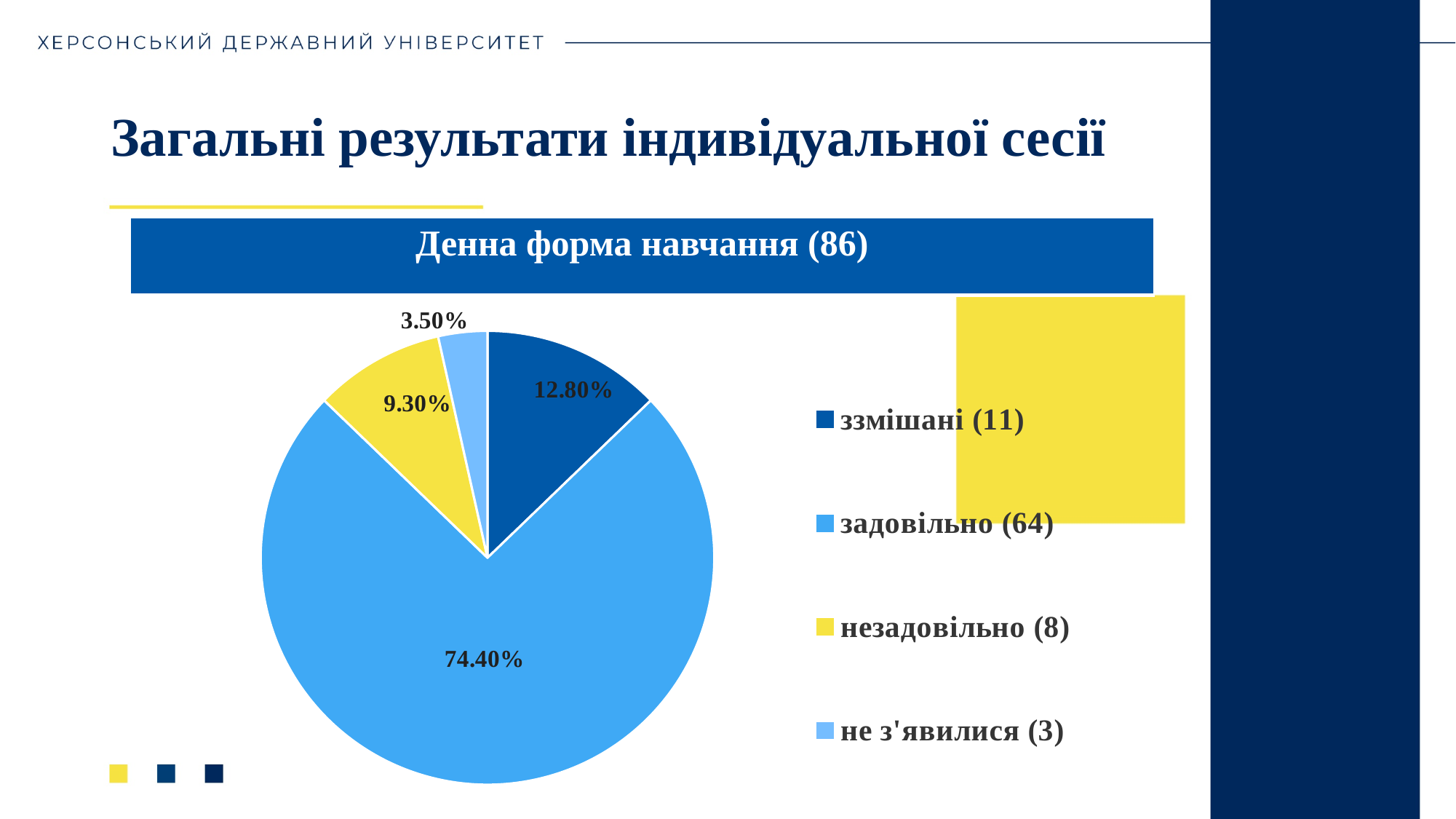
What percentage share does the slice for задовільно (64) have? 74.40% How many entries does the legend list? 4 How many slices does the pie chart have? 4 Which category has the smallest slice of the pie? не з'явилися (3) Which slice is larger: змішані (11) or незадовільно (8)? змішані (11) Which category has the largest slice of the pie? задовільно (64) What is the title shown above the pie chart? Денна форма навчання (86) What percentage share does the slice for змішані (11) have? 12.80% What is the difference in percentage points between the задовільно (64) slice and the змішані (11) slice? 61.60% What percentage share does the slice for не з'явилися (3) have? 3.50% What percentage share does the slice for незадовільно (8) have? 9.30% What kind of chart is shown on the slide? pie chart